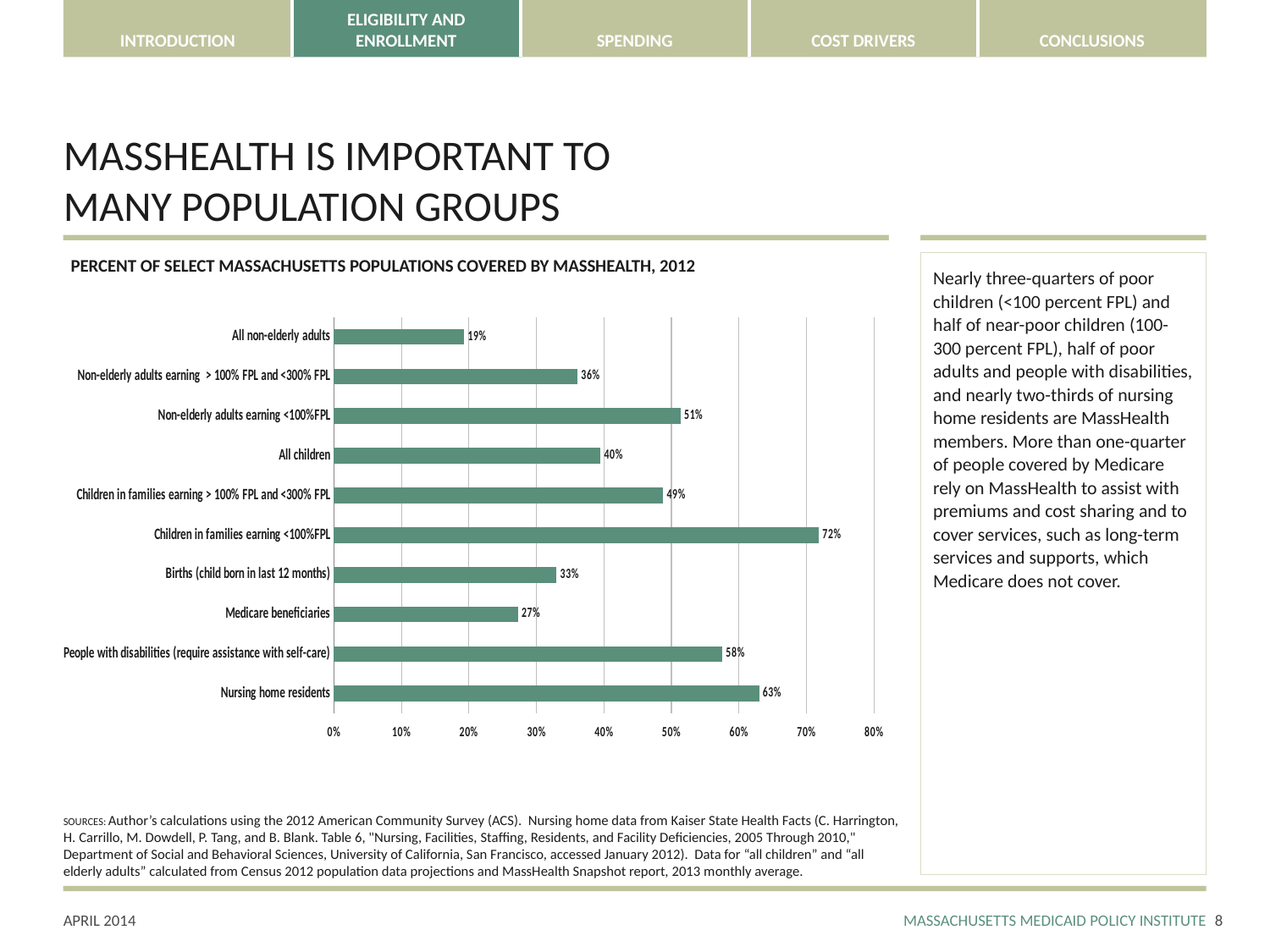
What is the title of the chart? Percent of select Massachusetts populations covered by MassHealth, 2012 How many population groups are shown in the chart? 10 Which population group has the lowest percent covered by MassHealth? All non-elderly adults Is the value for Births (child born in last 12 months) greater or less than 30%? greater What kind of chart is shown on the slide? Bar chart What is the value for Medicare beneficiaries? 27% What percent of nursing home residents are covered by MassHealth? 63% Which is larger: the value for People with disabilities (require assistance with self-care) or the value for Non-elderly adults earning <100%FPL? People with disabilities (require assistance with self-care) Which population group has the highest percent covered by MassHealth? Children in families earning <100%FPL What is the difference between the value for Children in families earning <100%FPL and the value for All children? 32% What percent of all children are covered by MassHealth? 40% What is the difference between the value for Nursing home residents and the value for Medicare beneficiaries? 36%